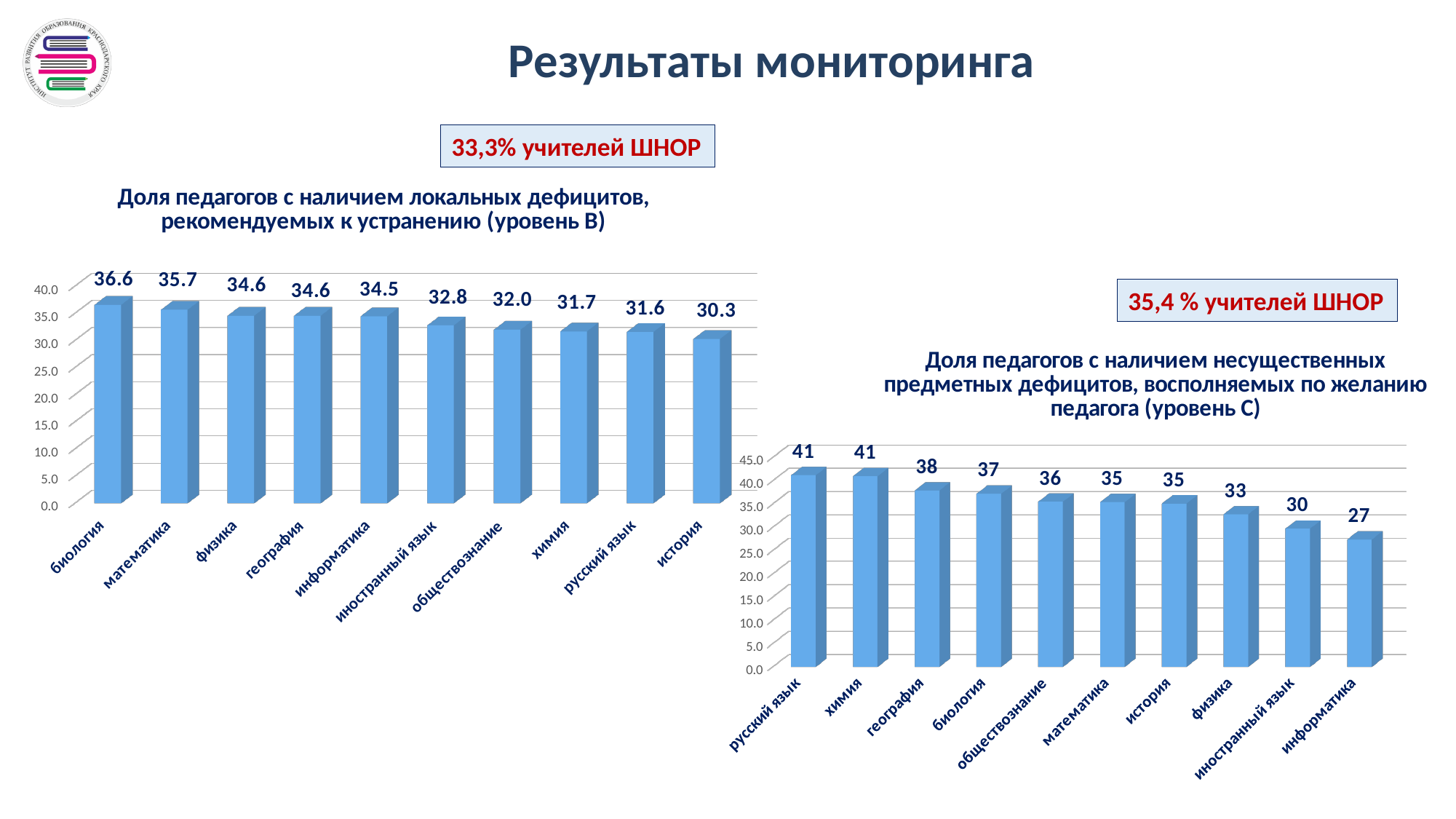
What kind of chart is the right chart (уровень С)? bar chart In the right chart (уровень С), which category has the lowest value? информатика In the left chart (уровень В), what is the difference between the values for биология and история? 6.3 In the right chart (уровень С), what is the value for информатика? 27 In the left chart (уровень В), do the values rise or fall from left to right along the x axis? fall In the left chart (уровень В), how many categories are shown? 10 In the right chart (уровень С), what is the difference between the values for химия and биология? 4 In the left chart (уровень В), what is the value for иностранный язык? 32.8 In the right chart (уровень С), which is larger, the value for физика or the value for иностранный язык? физика In the left chart (уровень В), which category has the lowest value? история In the left chart (уровень В), what is the value for биология? 36.6 In the right chart (уровень С), what is the value for география? 38